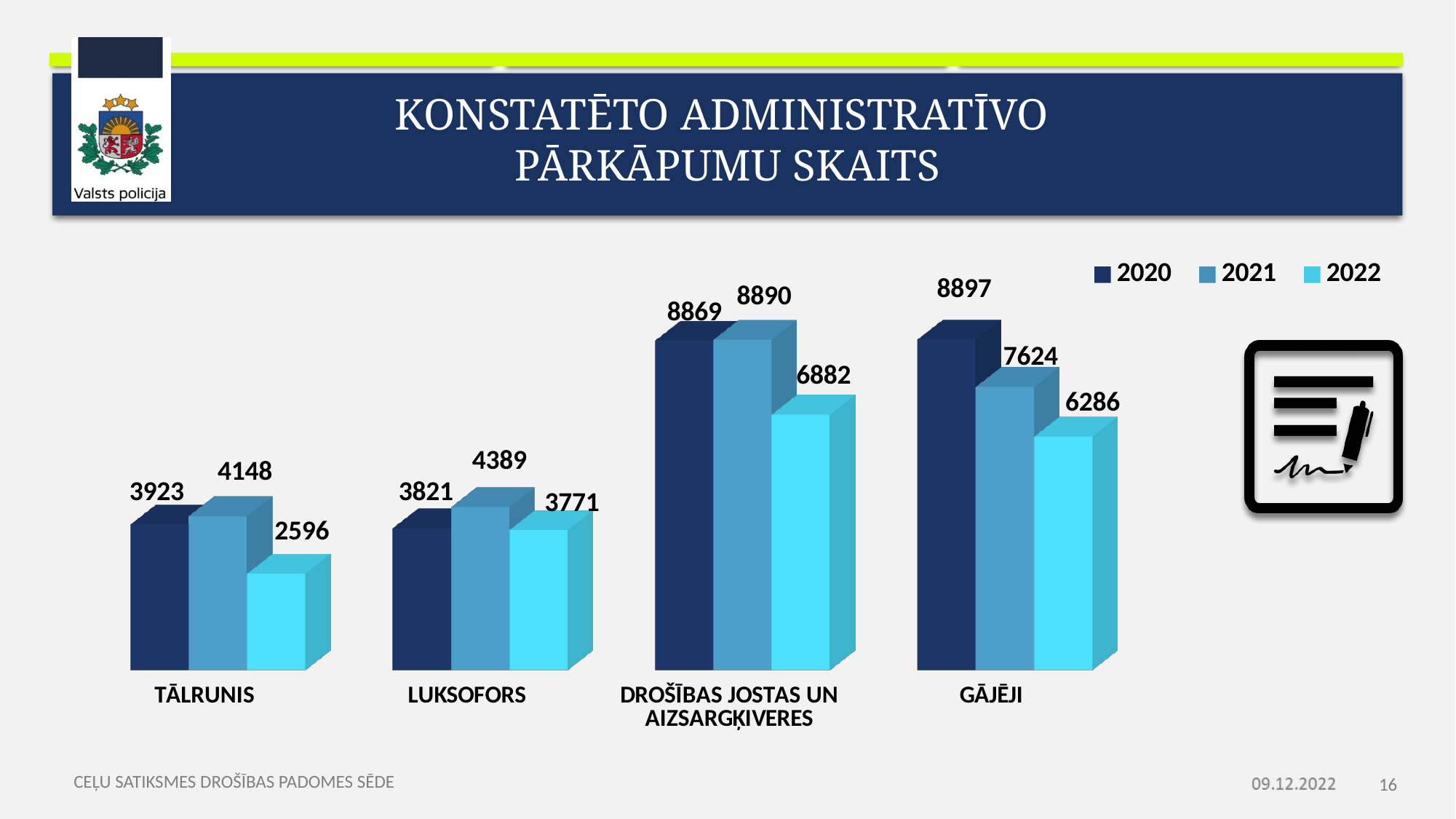
What is the difference between the 2021 and 2022 values for GĀJĒJI? 1338 What kind of chart is shown on the slide? bar chart What is the value for DROŠĪBAS JOSTAS UN AIZSARGĶIVERES in 2022? 6882 How many series does the legend list? 3 Which category has the lowest value in 2020? LUKSOFORS Which category has the highest value in 2022? DROŠĪBAS JOSTAS UN AIZSARGĶIVERES Which is larger for LUKSOFORS: the 2020 value or the 2022 value? 2020 What is the value for TĀLRUNIS in 2022? 2596 What is the value for GĀJĒJI in 2020? 8897 What is the difference between the 2020 and 2021 values for TĀLRUNIS? 225 How many categories are shown on the x axis? 4 What is the value for LUKSOFORS in 2021? 4389